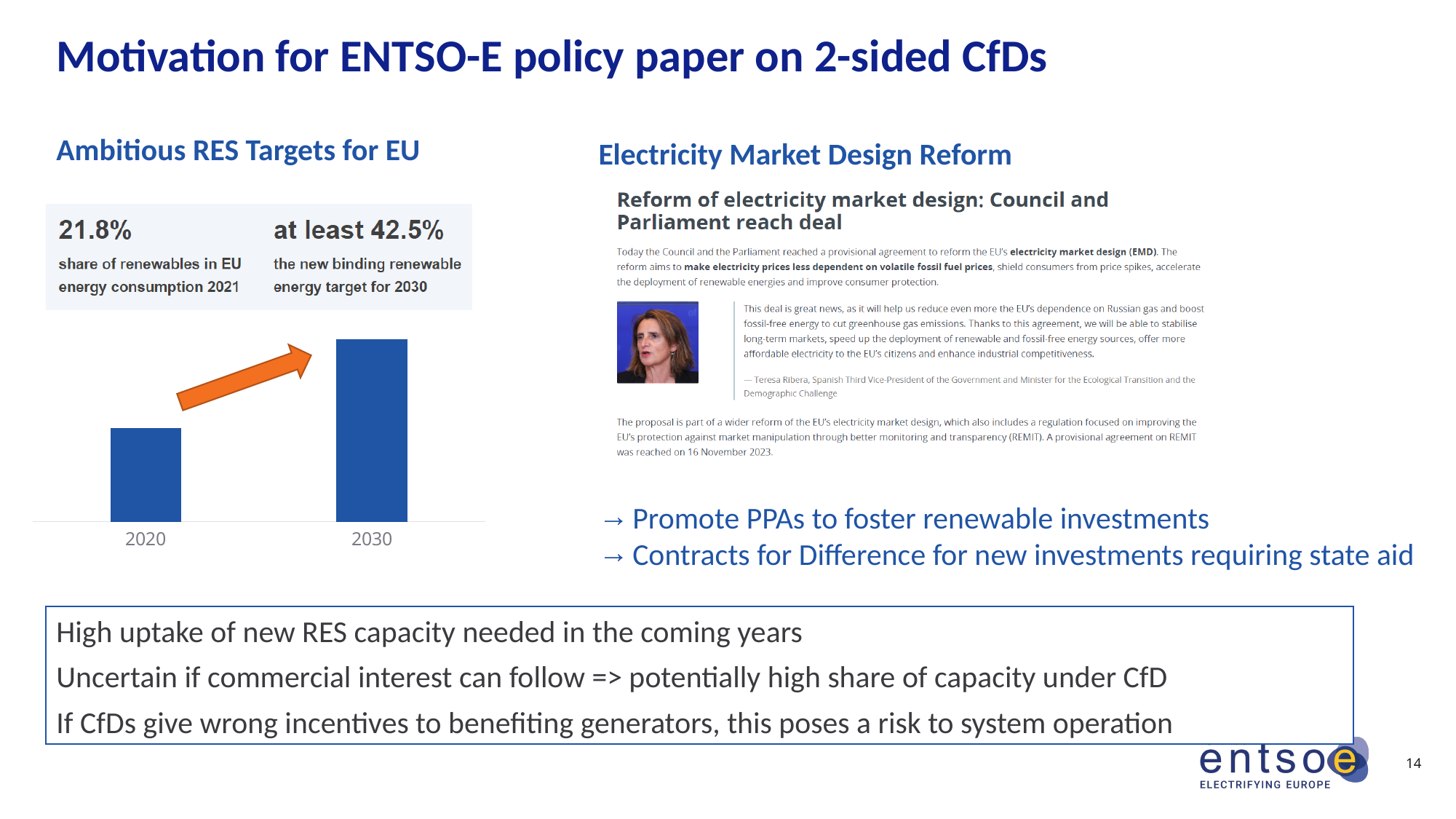
Which category has the taller bar in the chart under "Ambitious RES Targets for EU", 2020 or 2030? 2030 What colour are the bars in the chart under "Ambitious RES Targets for EU"? blue What are the two category labels on the x axis of the chart under "Ambitious RES Targets for EU"? 2020 and 2030 How many bars does the chart under "Ambitious RES Targets for EU" show? 2 Which category has the highest bar in the chart under "Ambitious RES Targets for EU"? 2030 Which category has the lowest bar in the chart under "Ambitious RES Targets for EU"? 2020 Do the bars in the chart under "Ambitious RES Targets for EU" rise or fall from 2020 to 2030? rise What kind of chart is shown under "Ambitious RES Targets for EU"? bar chart